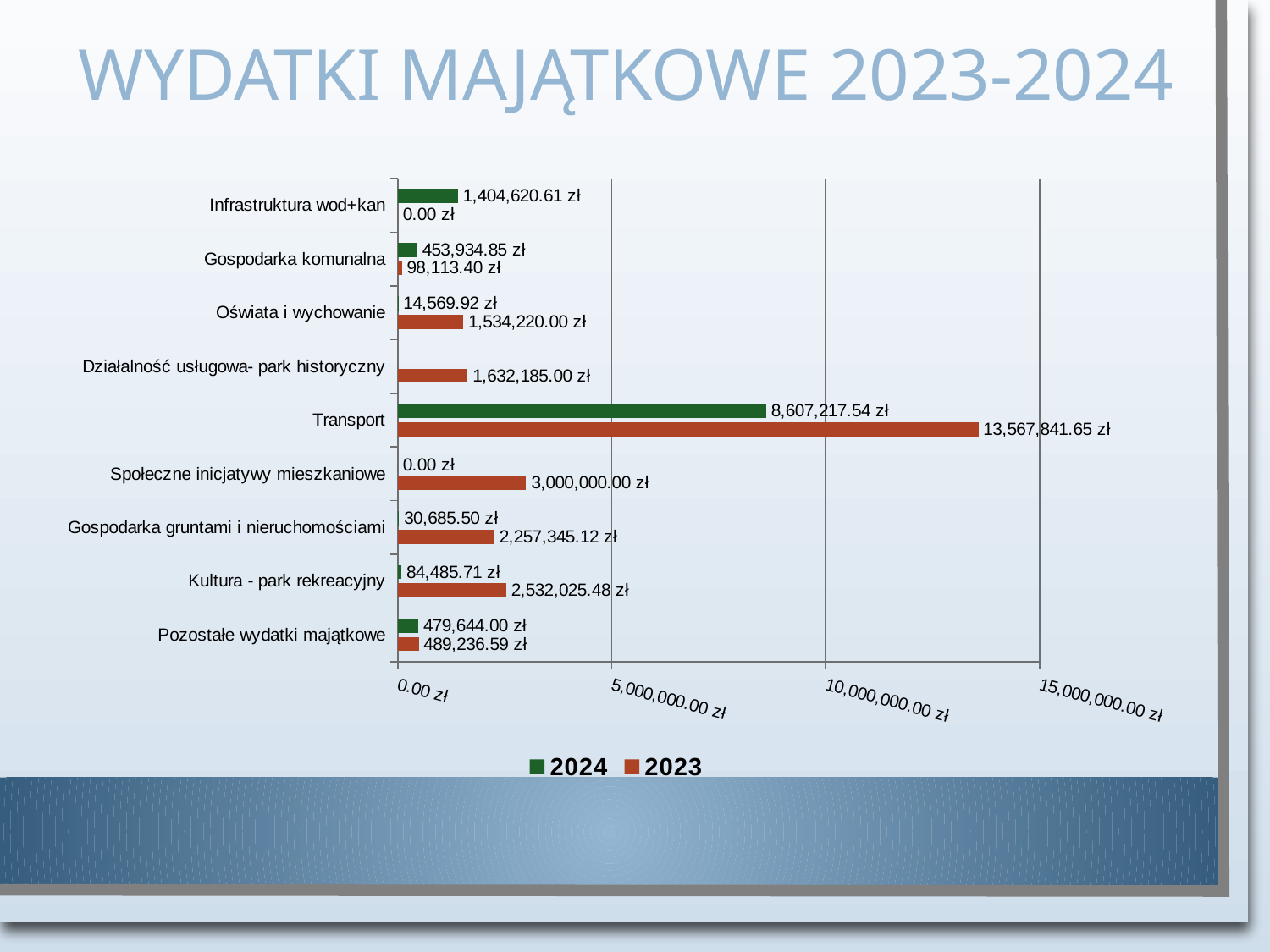
What is the difference between the 2024 and 2023 values for Gospodarka komunalna? 355,821.45 zł What type of chart is shown on the slide? Bar chart What is the 2024 value for Infrastruktura wod+kan? 1,404,620.61 zł Which category has the highest 2024 value? Transport What is the 2023 value for Transport? 13,567,841.65 zł Which is larger for Oświata i wychowanie, the 2023 value or the 2024 value? 2023 What is the difference between the 2023 and 2024 values for Transport? 4,960,624.11 zł What is the 2023 value for Społeczne inicjatywy mieszkaniowe? 3,000,000.00 zł How many series does the legend list? 2 Which category has the highest 2023 value? Transport What is the 2024 value for Kultura - park rekreacyjny? 84,485.71 zł How many categories are shown on the chart? 9